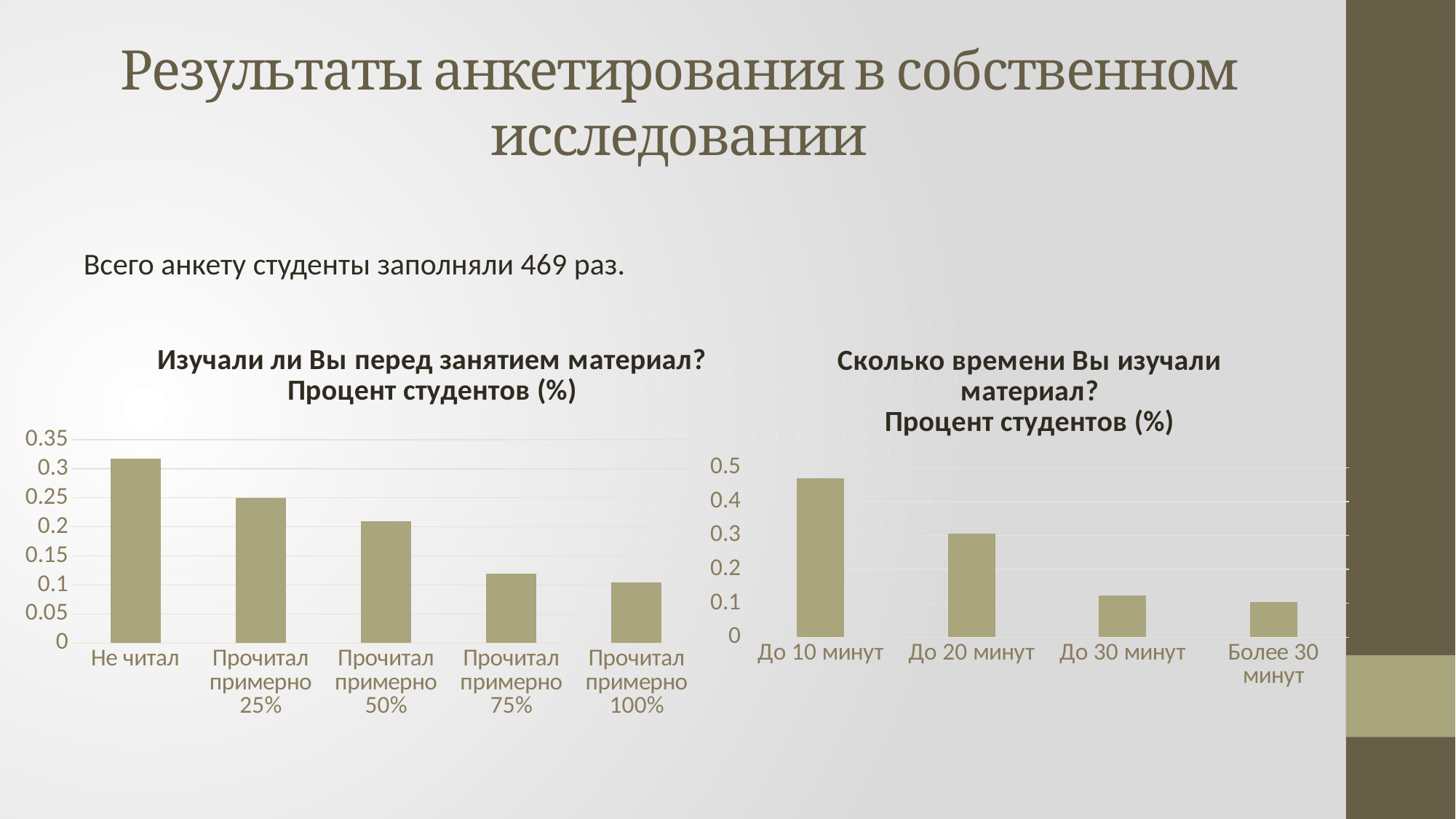
How many categories are shown in the left chart "Изучали ли Вы перед занятием материал?"? 5 How many categories are shown in the right chart "Сколько времени Вы изучали материал?"? 4 In the right chart "Сколько времени Вы изучали материал?", do the values rise or fall from left to right along the x axis? fall In the right chart "Сколько времени Вы изучали материал?", which category has the highest value? До 10 минут In the left chart "Изучали ли Вы перед занятием материал?", is the value for "Не читал" greater or less than 0.25? greater In the right chart "Сколько времени Вы изучали материал?", is the value for "Более 30 минут" greater or less than 0.2? less What kind of chart is the left chart titled "Изучали ли Вы перед занятием материал?"? bar chart In the left chart "Изучали ли Вы перед занятием материал?", which category has the highest value? Не читал What is the title of the right chart on the slide? Сколько времени Вы изучали материал? Процент студентов (%) In the right chart "Сколько времени Вы изучали материал?", is the value for "До 10 минут" greater or less than 0.4? greater In the left chart "Изучали ли Вы перед занятием материал?", which is larger: the value for "Прочитал примерно 25%" or "Прочитал примерно 50%"? Прочитал примерно 25%